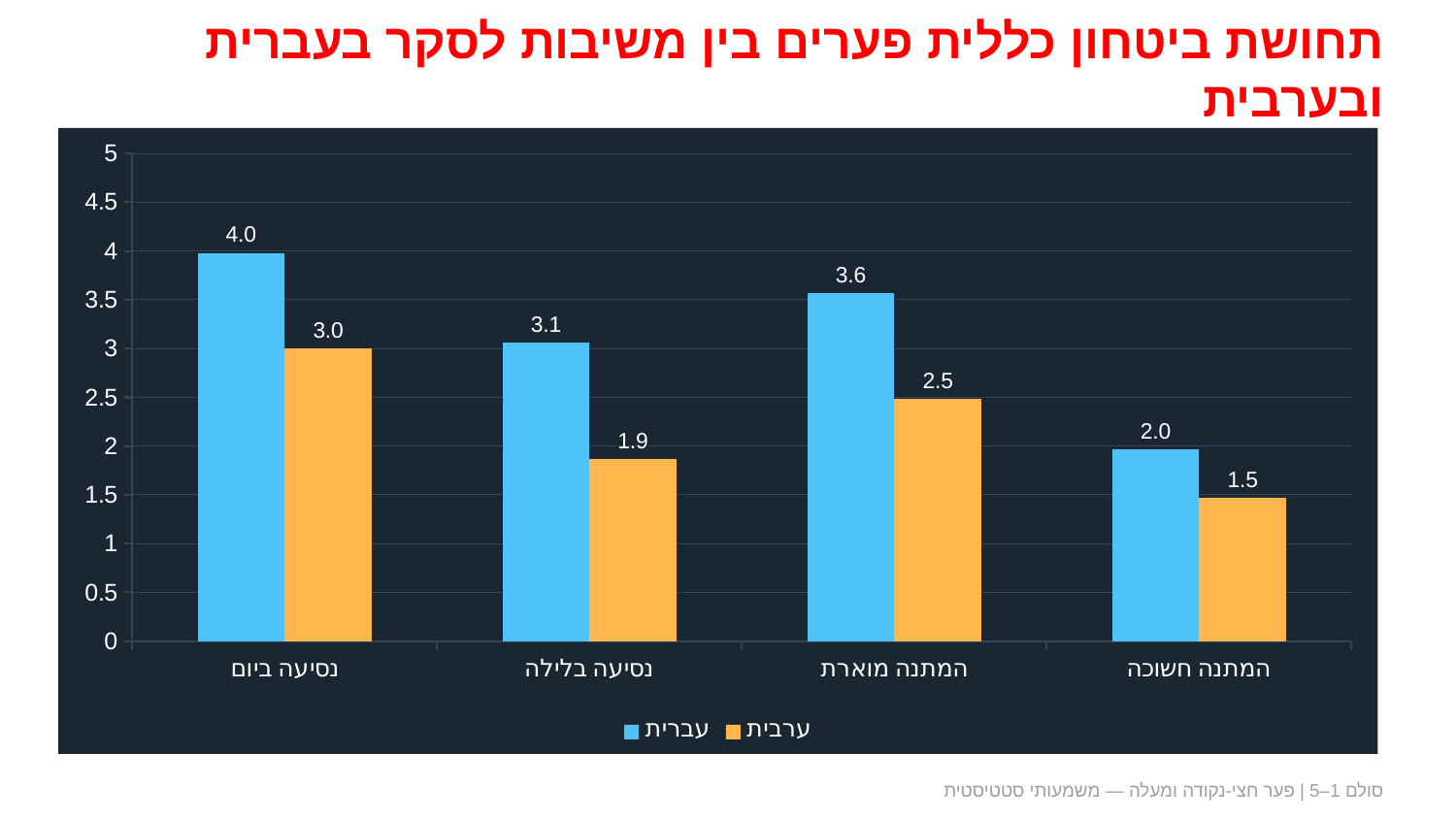
What is the difference between the עברית and ערבית values in the נסיעה בלילה category? 1.2 Which is larger: the ערבית value for נסיעה ביום or the עברית value for המתנה חשוכה? ערבית value for נסיעה ביום Is the עברית value for המתנה מוארת greater or less than 3? greater Which category has the lowest value for the ערבית series? המתנה חשוכה How many series does the legend list? 2 What is the value for ערבית in the המתנה מוארת category? 2.5 What kind of chart is shown on the slide? Bar chart Which category has the highest value for the עברית series? נסיעה ביום What is the value for ערבית in the נסיעה בלילה category? 1.9 What is the value for עברית in the נסיעה ביום category? 4.0 Which colour represents the ערבית series? Orange How many categories are shown on the x axis? 4